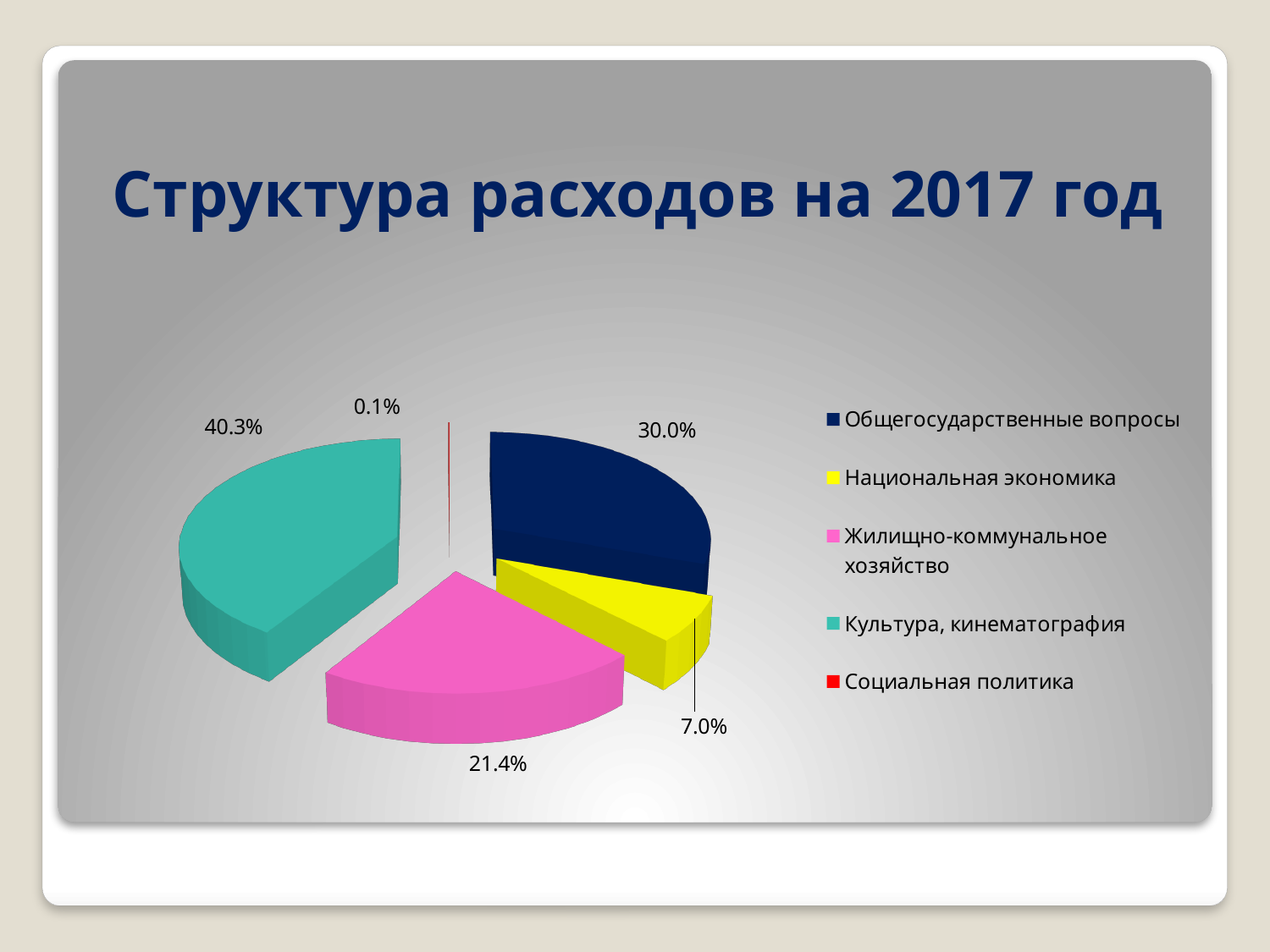
Which is larger: the share for Жилищно-коммунальное хозяйство or for Национальная экономика? Жилищно-коммунальное хозяйство What share of expenditures goes to Национальная экономика? 7.0% What share of expenditures goes to Социальная политика? 0.1% What share of expenditures goes to Общегосударственные вопросы? 30.0% Which category has the largest share of expenditures? Культура, кинематография What is the difference between the shares of Культура, кинематография and Общегосударственные вопросы? 10.3% What share of expenditures goes to Жилищно-коммунальное хозяйство? 21.4% Which category has the smallest share of expenditures? Социальная политика How many categories does the pie chart show? 5 What type of chart is shown on the slide? pie chart What is the title of the slide? Структура расходов на 2017 год What share of expenditures goes to Культура, кинематография? 40.3%